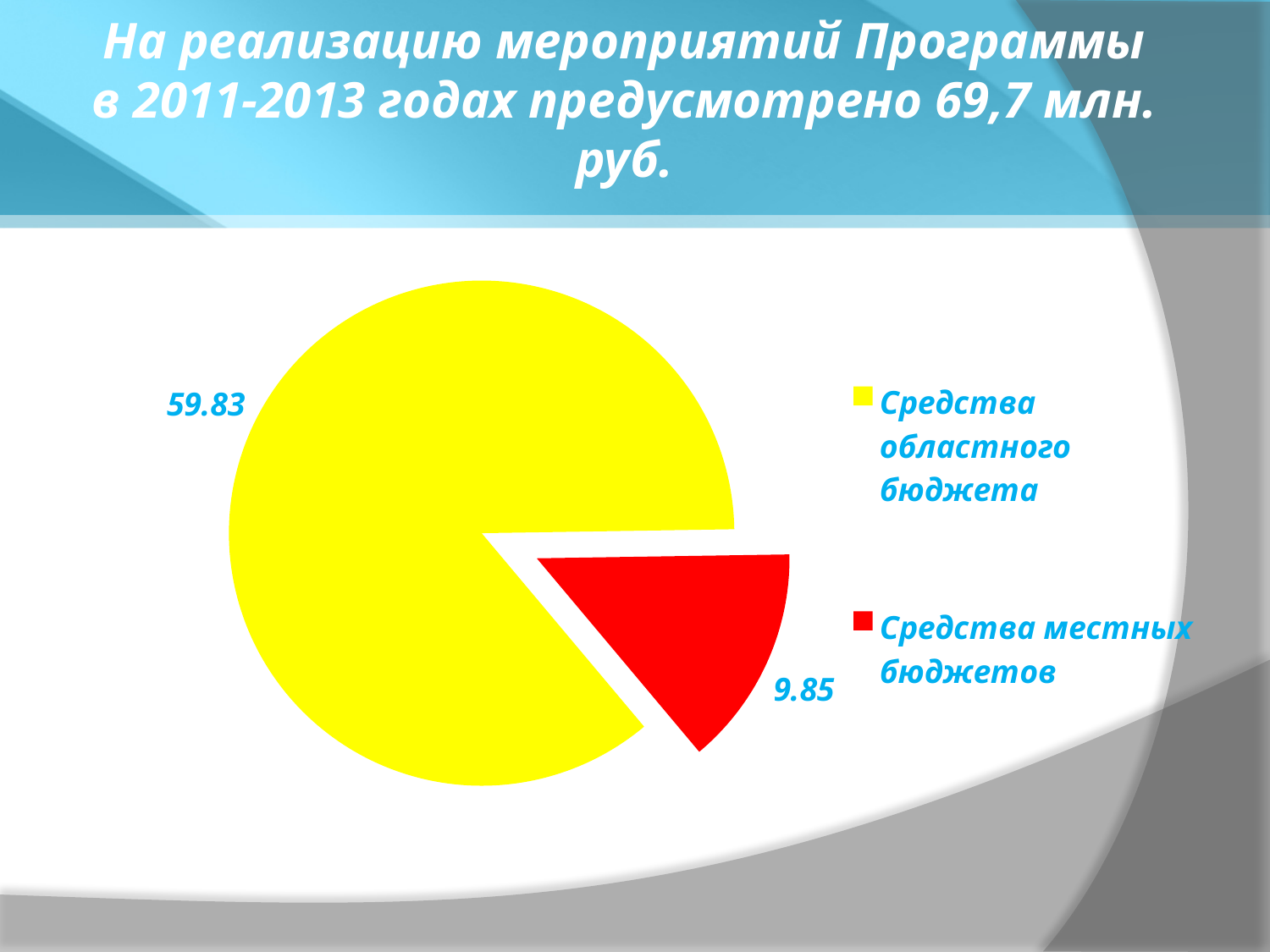
What is the sum of the two values shown on the pie chart? 69.68 What colour is the slice for Средства местных бюджетов? Red Which category has the smallest slice of the pie? Средства местных бюджетов What kind of chart is shown on the slide? Pie chart What is the difference between the values for Средства областного бюджета and Средства местных бюджетов? 49.98 Which category has the largest slice of the pie? Средства областного бюджета How many entries does the legend list? 2 How many slices does the pie chart have? 2 What value is shown for Средства местных бюджетов? 9.85 Which is larger: Средства областного бюджета or Средства местных бюджетов? Средства областного бюджета What value is shown for Средства областного бюджета? 59.83 What colour is the slice for Средства областного бюджета? Yellow